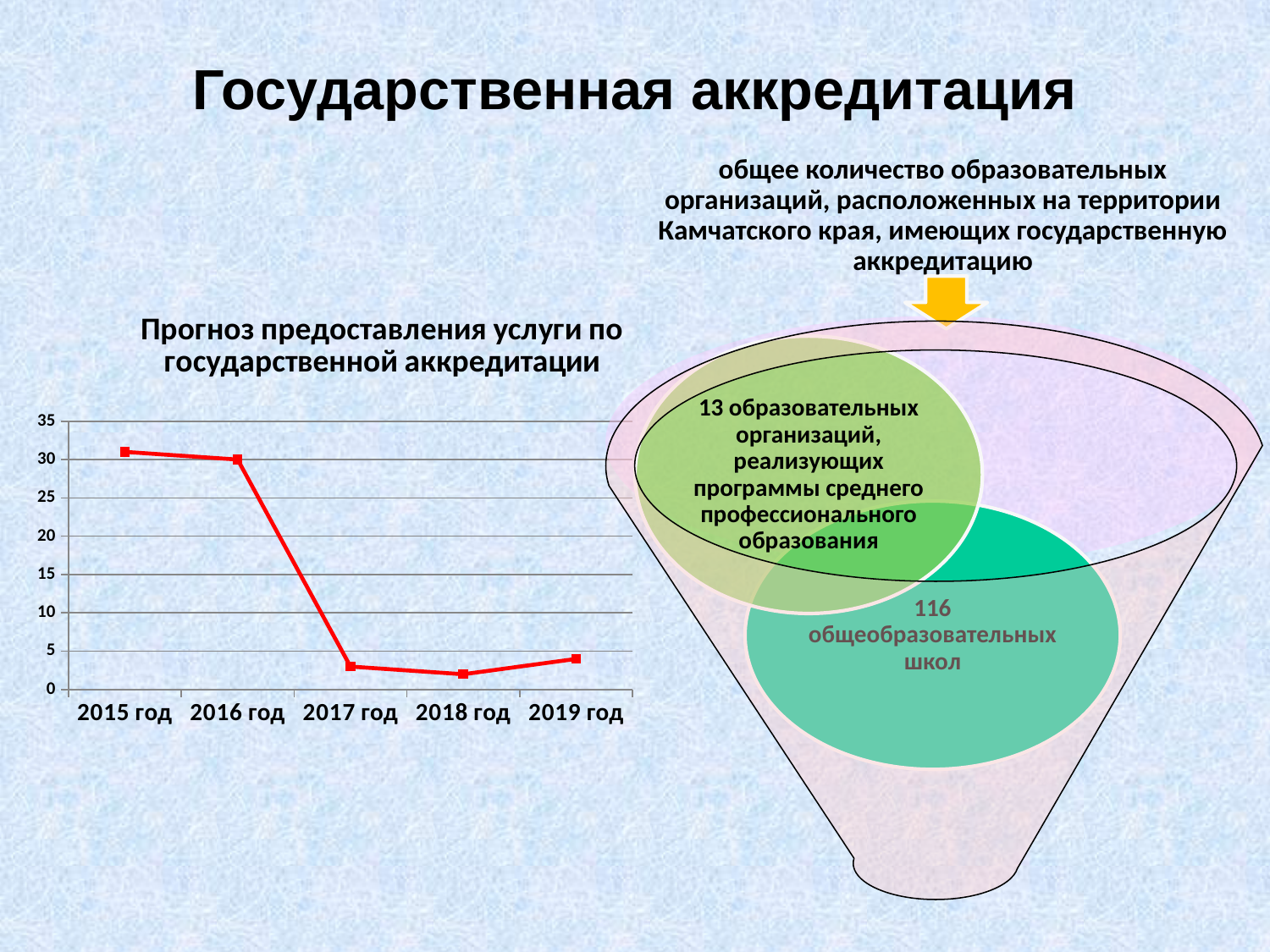
What is the title of the line chart on the left of the slide? Прогноз предоставления услуги по государственной аккредитации Is the value for 2015 год in the line chart greater or less than 25? greater In the line chart, which is larger: the value for 2016 год or the value for 2018 год? 2016 год Is the value for 2016 год in the line chart greater or less than 20? greater Is the value for 2019 год in the line chart greater or less than 10? less What kind of chart is "Прогноз предоставления услуги по государственной аккредитации"? line chart What colour is the line in the line chart? red In the line chart, which is larger: the value for 2015 год or the value for 2017 год? 2015 год Do the values in the line chart rise or fall overall from 2015 год to 2019 год? fall How many years are plotted on the x axis of the line chart? 5